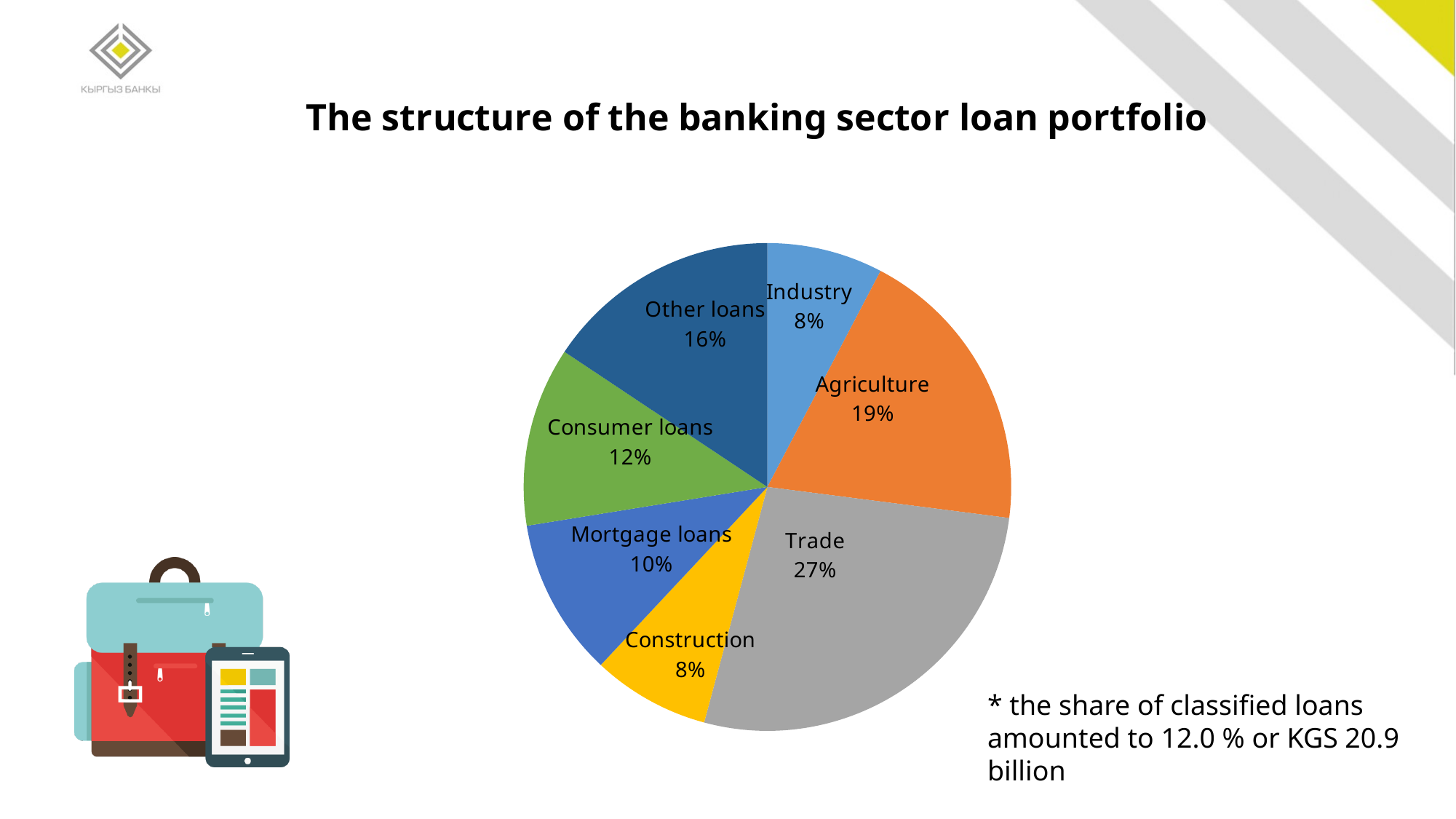
What is the title of the slide? The structure of the banking sector loan portfolio What share of the loan portfolio is Consumer loans? 12% What share of the loan portfolio is Trade? 27% What share of the loan portfolio is Agriculture? 19% Which category has the largest share of the loan portfolio? Trade How many categories are shown in the pie chart? 7 Which categories share the smallest slice of the pie? Industry and Construction Which is larger, Other loans or Consumer loans? Other loans What is the difference in percentage points between Trade and Agriculture? 8 What kind of chart is shown on the slide? Pie chart What share of the loan portfolio is Mortgage loans? 10% What colour is the Trade slice? Grey